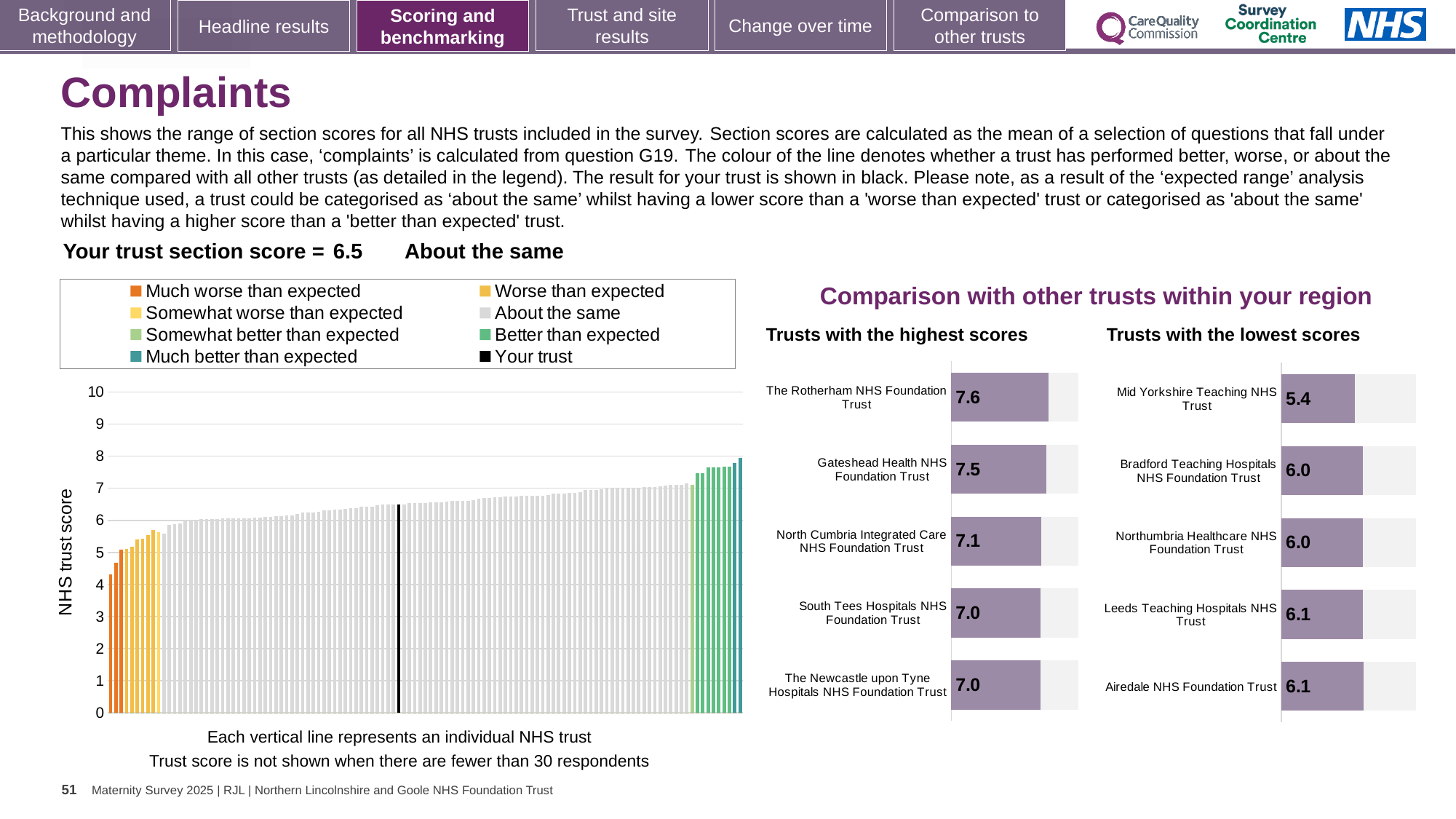
In the large 'NHS trust score' chart on the left, do the values rise or fall from left to right along the x axis? Rise What is the difference between The Rotherham NHS Foundation Trust's score in the 'Trusts with the highest scores' chart and Mid Yorkshire Teaching NHS Trust's score in the 'Trusts with the lowest scores' chart? 2.2 In the 'Trusts with the highest scores' chart, which trust has the highest score? The Rotherham NHS Foundation Trust In the 'Trusts with the lowest scores' chart, which trust has the lowest score? Mid Yorkshire Teaching NHS Trust In the 'Trusts with the highest scores' chart, which has the larger score: Gateshead Health NHS Foundation Trust or North Cumbria Integrated Care NHS Foundation Trust? Gateshead Health NHS Foundation Trust How many trusts are shown in the 'Trusts with the lowest scores' chart? 5 In the large 'NHS trust score' chart on the left, is the value of the lowest (leftmost) bar greater or less than 5? less In the 'Trusts with the lowest scores' chart, what is the score for Mid Yorkshire Teaching NHS Trust? 5.4 What kind of chart is the large 'NHS trust score' chart on the left? Bar chart How many entries does the legend of the large 'NHS trust score' chart list? 8 In the 'Trusts with the highest scores' chart, what is the score for The Rotherham NHS Foundation Trust? 7.6 In the large 'NHS trust score' chart on the left, what colour is the bar representing your trust? Black